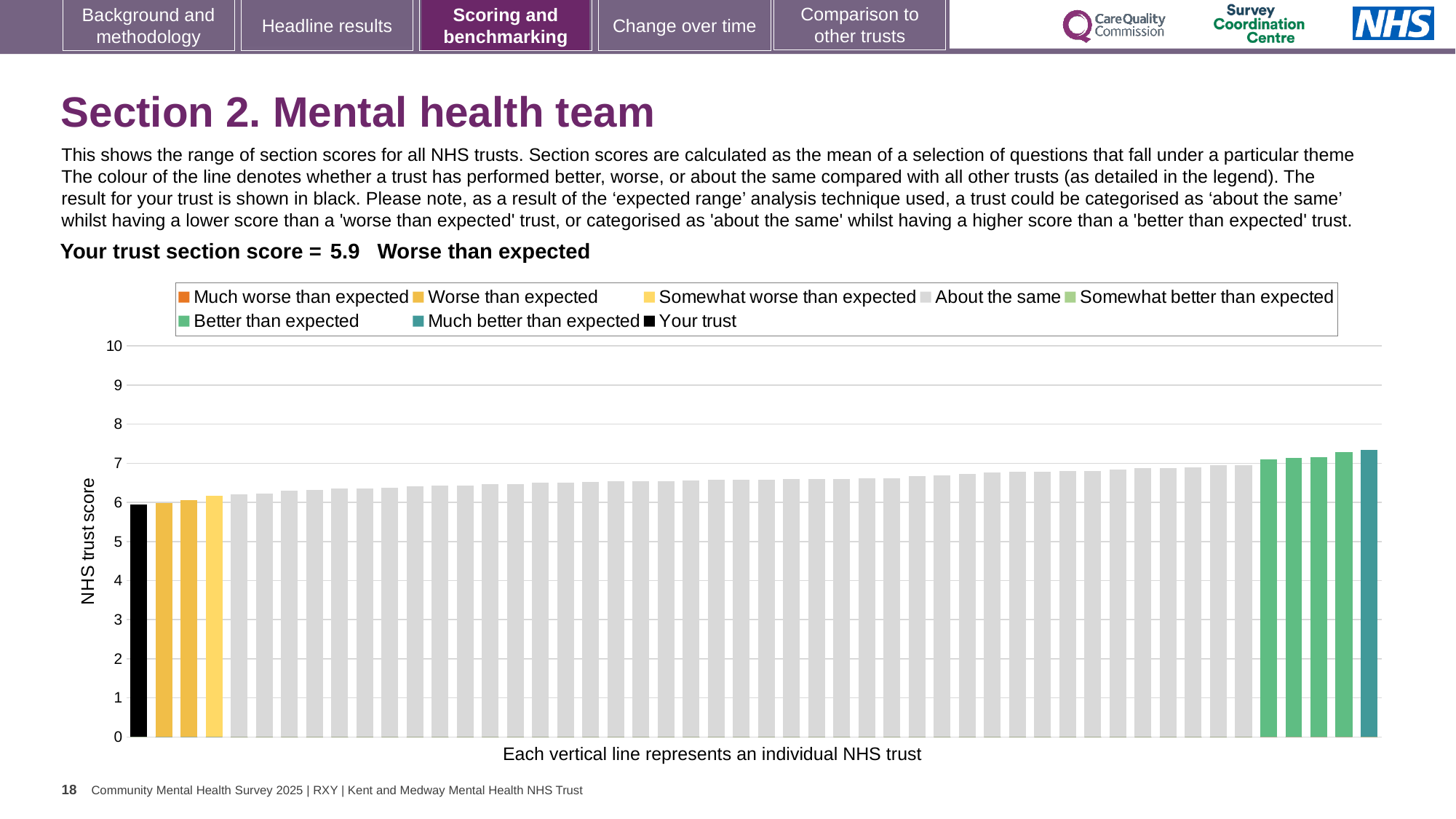
How many entries does the chart legend list? 8 What is the label on the vertical axis of the chart? NHS trust score What kind of chart is shown on the slide? bar chart How many trusts are shown in the 'Much better than expected' category? 1 What colour is the bar representing your trust? black Which bar shows the lowest score on the chart? Your trust (the black bar) Do the trust scores rise or fall from left to right along the x axis? rise Which category is your trust's section score placed in? Worse than expected Which legend category does the highest-scoring trust belong to? Much better than expected Is the score of the rightmost (highest) trust greater or less than 7? greater Is your trust's section score greater or less than 6? less What is the section score for your trust shown on the slide? 5.9